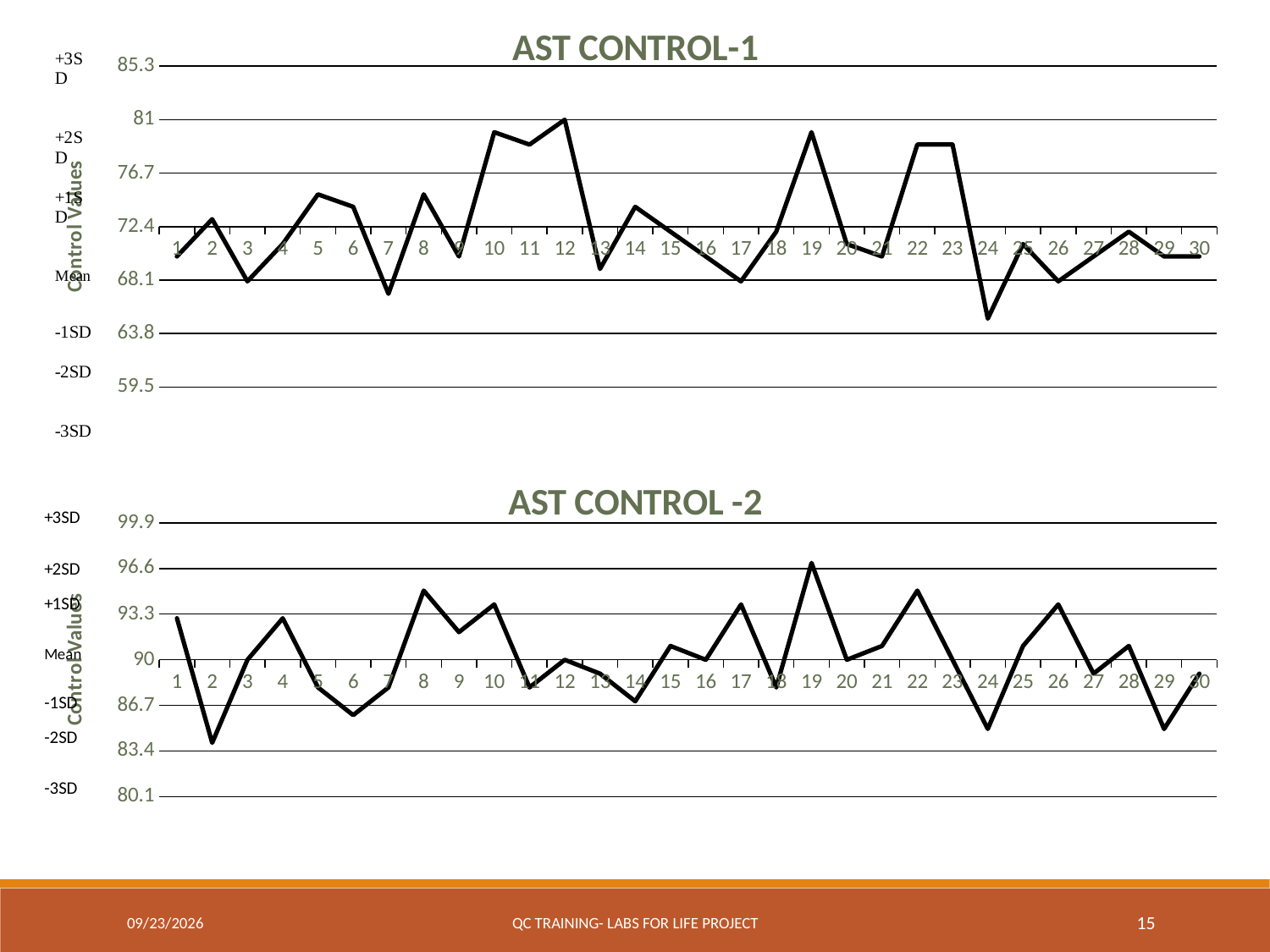
What is the y-axis label on the AST CONTROL -2 chart? Control Values What type of chart is the AST CONTROL-1 chart? line chart How many data points are plotted on the AST CONTROL -2 chart? 30 On the AST CONTROL-1 chart, is the value at point 19 greater or less than 76.7? greater On the AST CONTROL-1 chart, which point number has the highest value? 12 On the AST CONTROL-1 chart, is the value at point 24 greater or less than 68.1? less On the AST CONTROL-1 chart, which point number has the lowest value? 24 How many data points are plotted on the AST CONTROL-1 chart? 30 On the AST CONTROL-1 chart, which is larger, the value at point 12 or the value at point 24? point 12 On the AST CONTROL -2 chart, which point number has the highest value? 19 On the AST CONTROL -2 chart, is the value at point 2 greater or less than 86.7? less On the AST CONTROL -2 chart, which point number has the lowest value? 2